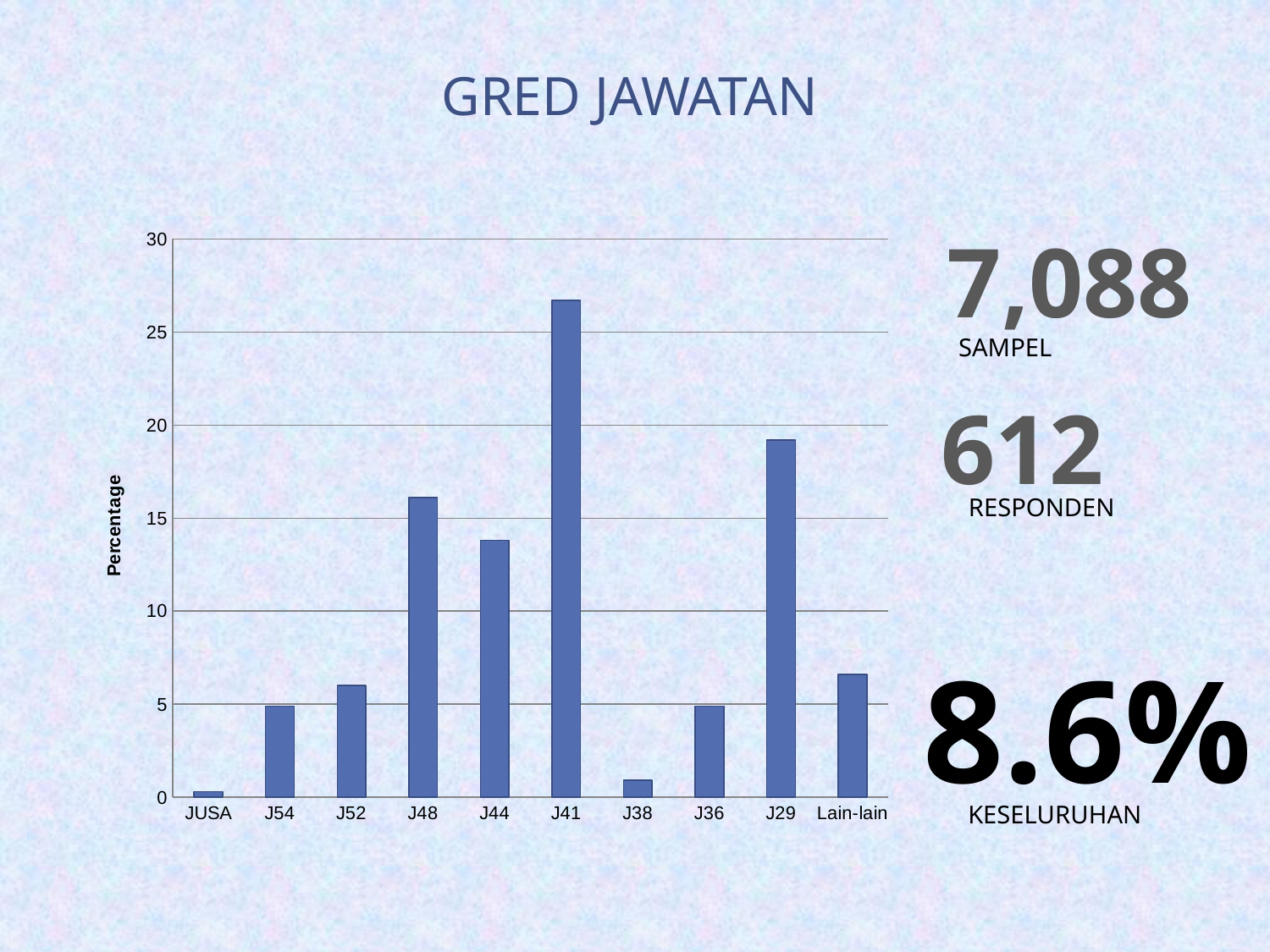
What kind of chart is shown on the slide? bar chart Is the value for J48 greater or less than 15? greater How many categories are shown on the x axis? 10 What is the label on the vertical axis of the chart? Percentage Is the value for Lain-lain greater or less than 5? greater Is the value for J41 greater or less than 25? greater Which category has the lowest percentage? JUSA Which is larger, the value for J29 or the value for J52? J29 Which category has the highest percentage? J41 Which is larger, the value for J48 or the value for J44? J48